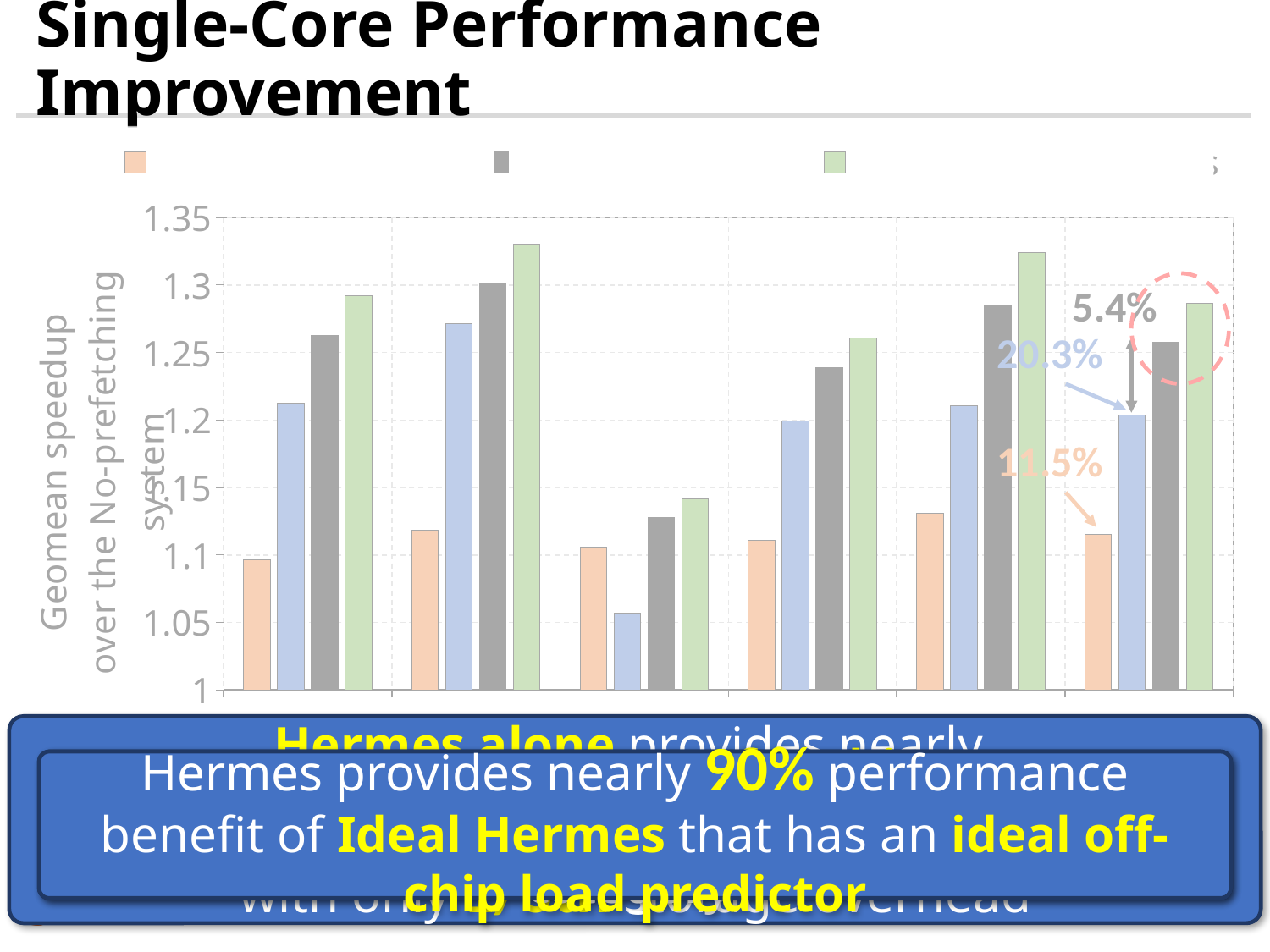
What is the highest value shown on the y axis? 1.35 How many groups of bars are plotted along the x axis? 6 What is the label on the y axis? Geomean speedup over the No-prefetching system Is the value of the orange bar in the last group greater or less than 1.15? less What kind of chart is shown on the slide? bar chart Is the value of the green bar in the first group greater or less than 1.25? greater Which bar in the third group is the lowest? the blue bar Is the value of the gray bar in the second group greater or less than 1.25? greater How many bars are there in each group? 4 In which group is the blue bar the lowest? the third group